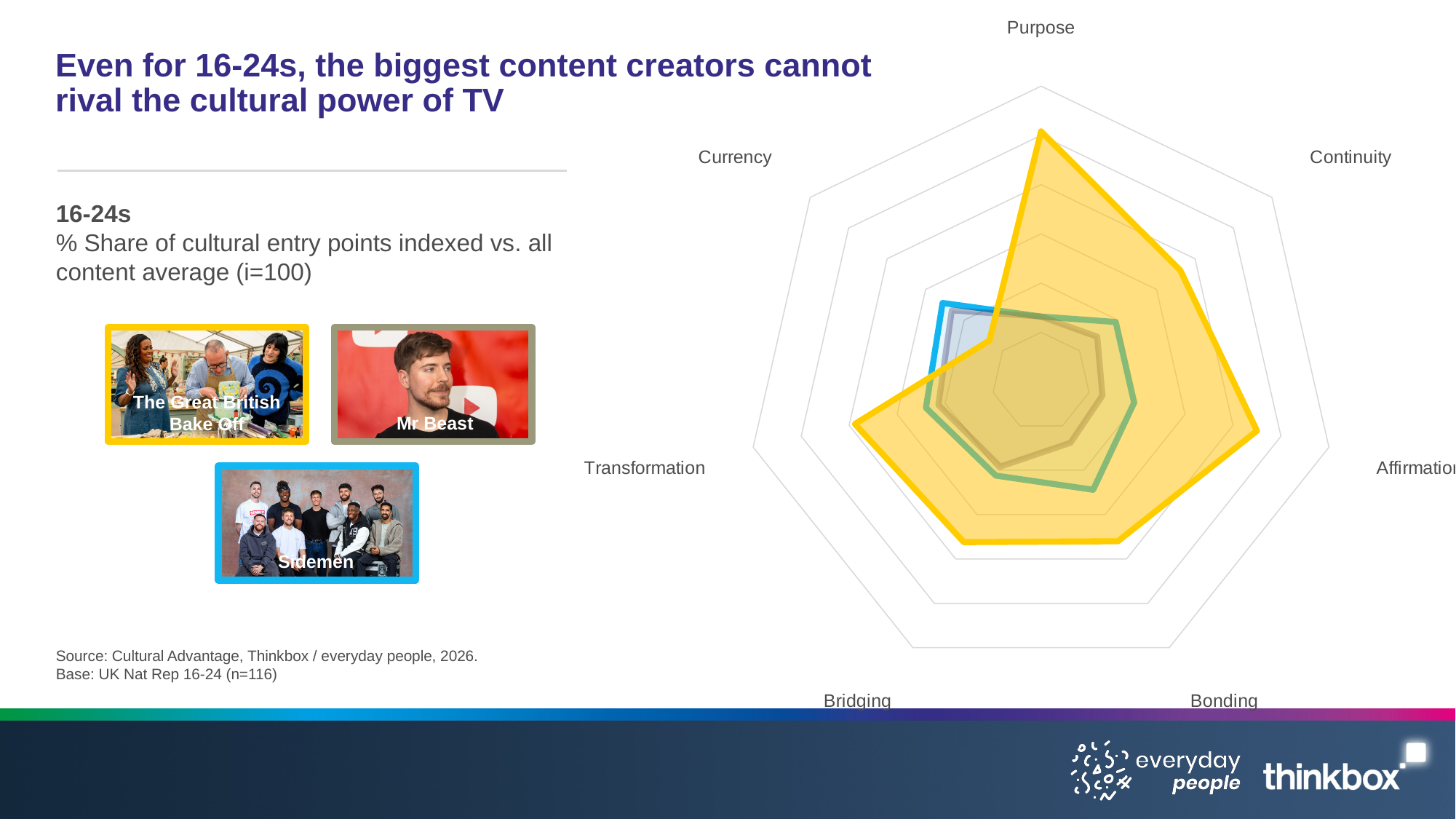
On the Affirmation axis, which is larger: The Great British Bake Off or Mr Beast? The Great British Bake Off Which series has the highest value on the Purpose axis? The Great British Bake Off What kind of chart is shown on the slide? Radar chart How many axes (cultural entry points) does the radar chart have? 7 On the Currency axis, which is larger: Sidemen or Mr Beast? Sidemen On the Transformation axis, which is larger: The Great British Bake Off or Sidemen? The Great British Bake Off What is the base sample size (n) stated for the chart? n=116 Which series is drawn in yellow on the radar chart? The Great British Bake Off How many series are plotted on the radar chart? 3 On which axis does The Great British Bake Off reach its highest value? Purpose